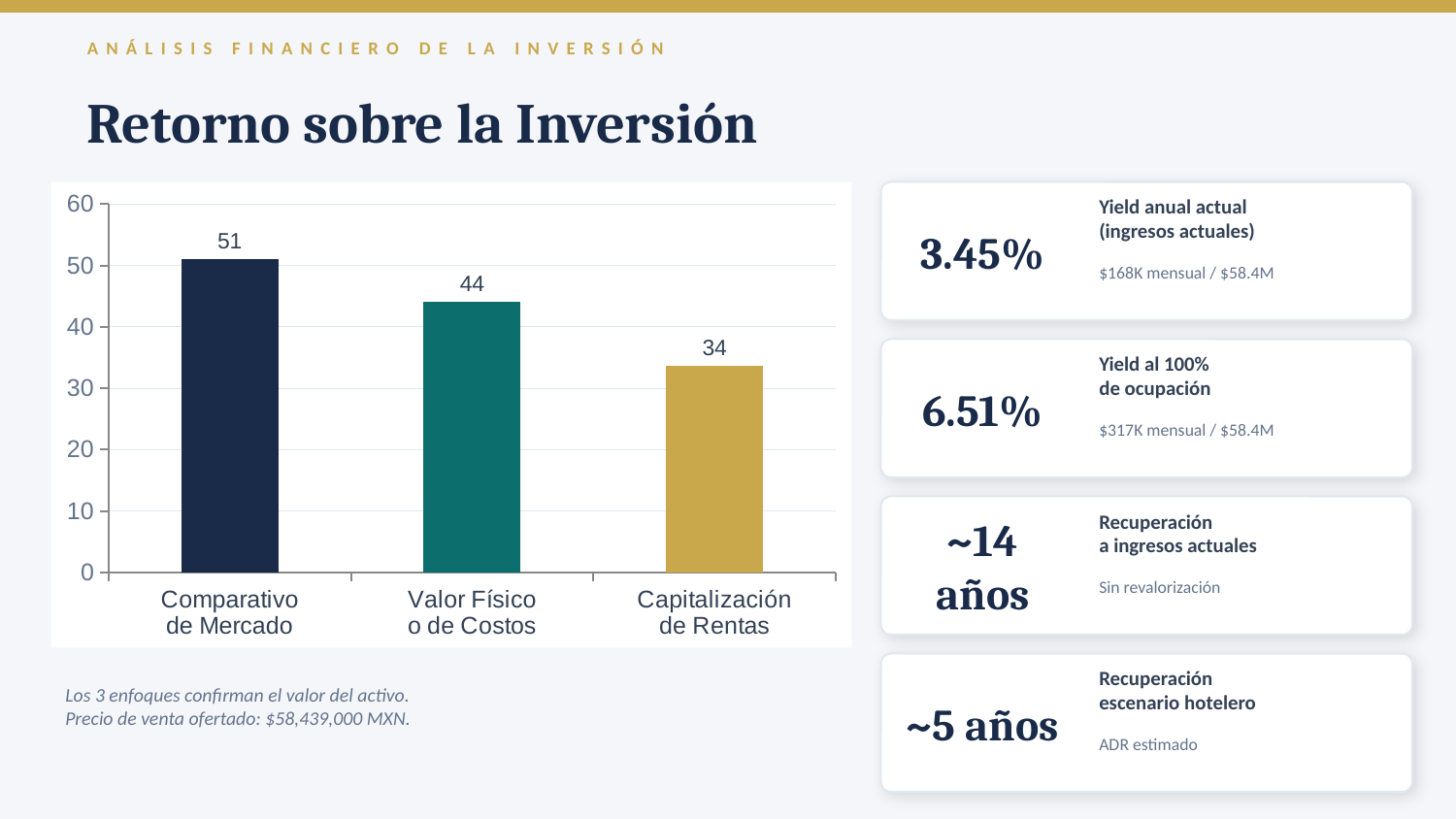
Is the value for Comparativo de Mercado greater or less than 40? greater Do the values rise or fall from left to right across the categories? fall What is the difference between the values for Valor Físico o de Costos and Capitalización de Rentas? 10 Which is larger, the value for Valor Físico o de Costos or the value for Capitalización de Rentas? Valor Físico o de Costos What is the difference between the values for Comparativo de Mercado and Capitalización de Rentas? 17 How many categories are shown on the chart? 3 What is the value for Capitalización de Rentas? 34 What kind of chart is shown on the slide? bar chart Which category has the highest value? Comparativo de Mercado What is the value for Valor Físico o de Costos? 44 Which category has the lowest value? Capitalización de Rentas What is the value for Comparativo de Mercado? 51